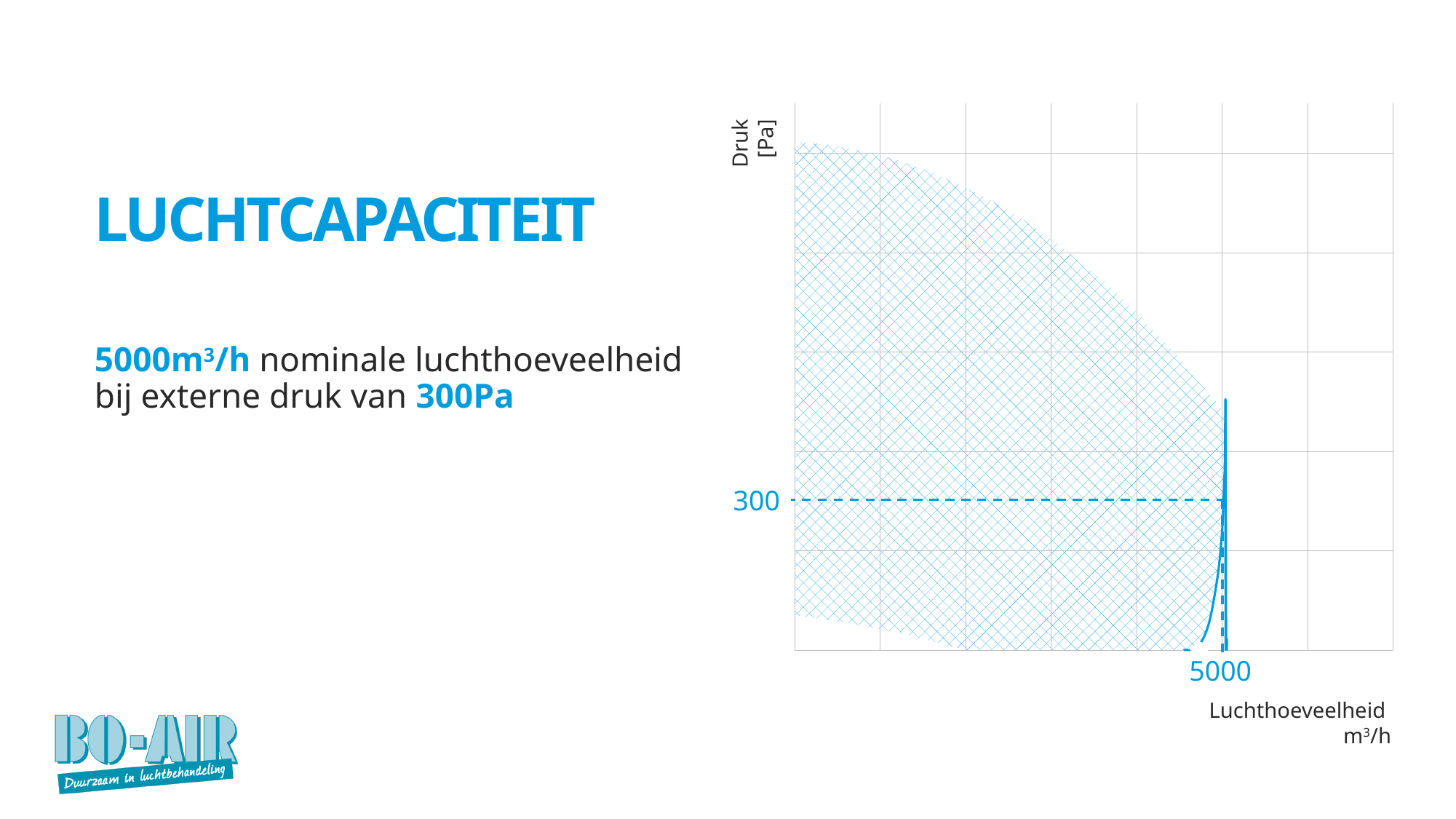
How many numeric tick labels are printed on the horizontal axis? 1 What is the title of the slide containing the chart? LUCHTCAPACITEIT At an airflow of 5000 m³/h, what external pressure does the dashed line indicate? 300 What is the label of the vertical axis of the chart? Druk [Pa] What is the label of the horizontal axis of the chart? Luchthoeveelheid m³/h What kind of chart is shown on the slide? area chart What pressure value is marked on the vertical axis by the dashed line? 300 How many numeric tick labels are printed on the vertical axis? 1 Does the upper boundary of the hatched operating area rise or fall as the airflow increases along the x axis? fall What airflow value is marked on the horizontal axis by the dashed line? 5000